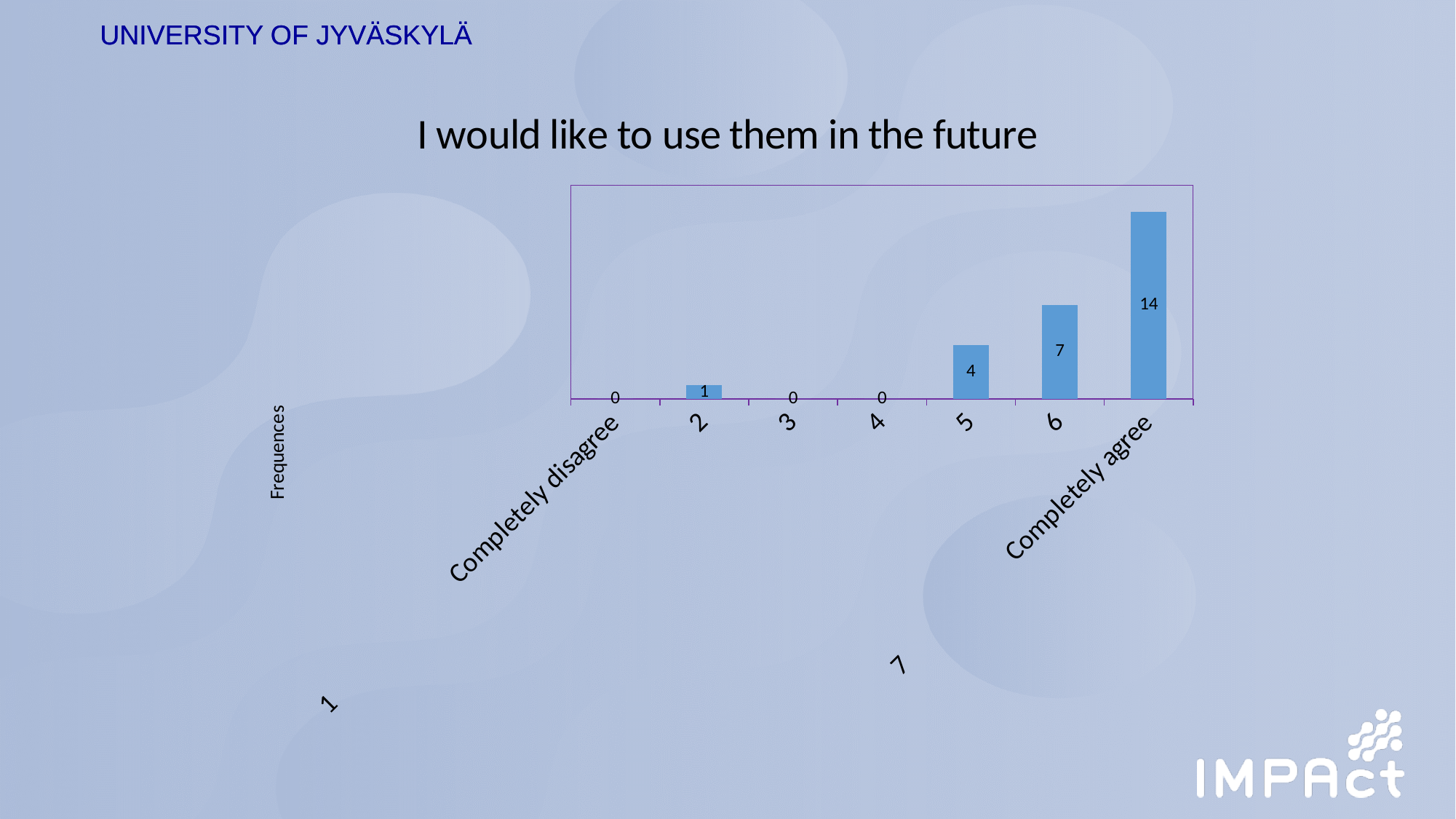
What is the difference between the values for category 6 and category 5? 3 What is the value for "Completely agree"? 14 What is the difference between the values for "Completely agree" and category 6? 7 What is the value for "Completely disagree"? 0 How many categories are shown on the x axis? 7 Which category has the highest value? Completely agree Which is larger, the value for category 5 or the value for category 6? category 6 What is the value for category 2? 1 What kind of chart is shown? bar chart What is the value for category 6? 7 What is the value for category 5? 4 What is the title of the chart? I would like to use them in the future